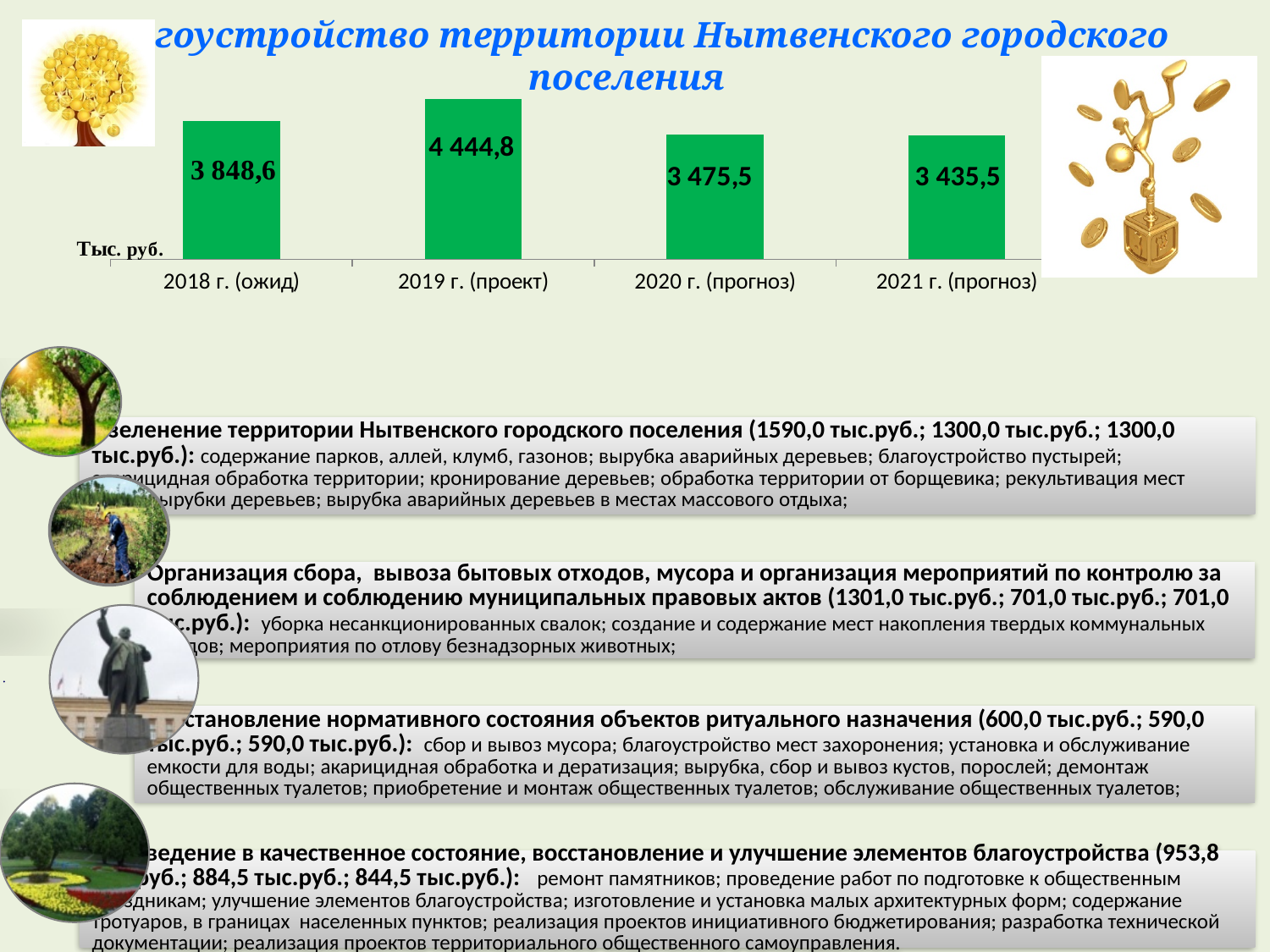
What unit is indicated for the values on the chart? Тыс. руб. Which is larger, the value for 2018 г. (ожид) or the value for 2020 г. (прогноз)? 2018 г. (ожид) Which year has the lowest value? 2021 г. (прогноз) What is the value for 2018 г. (ожид)? 3 848,6 What kind of chart is shown on the slide? bar chart What is the difference between the values for 2020 г. (прогноз) and 2021 г. (прогноз)? 40,0 What is the value for 2021 г. (прогноз)? 3 435,5 Do the values rise or fall from 2019 г. (проект) to 2021 г. (прогноз)? fall What is the value for 2019 г. (проект)? 4 444,8 How many years are shown on the chart? 4 What is the difference between the values for 2019 г. (проект) and 2018 г. (ожид)? 596,2 Which year has the highest value? 2019 г. (проект)